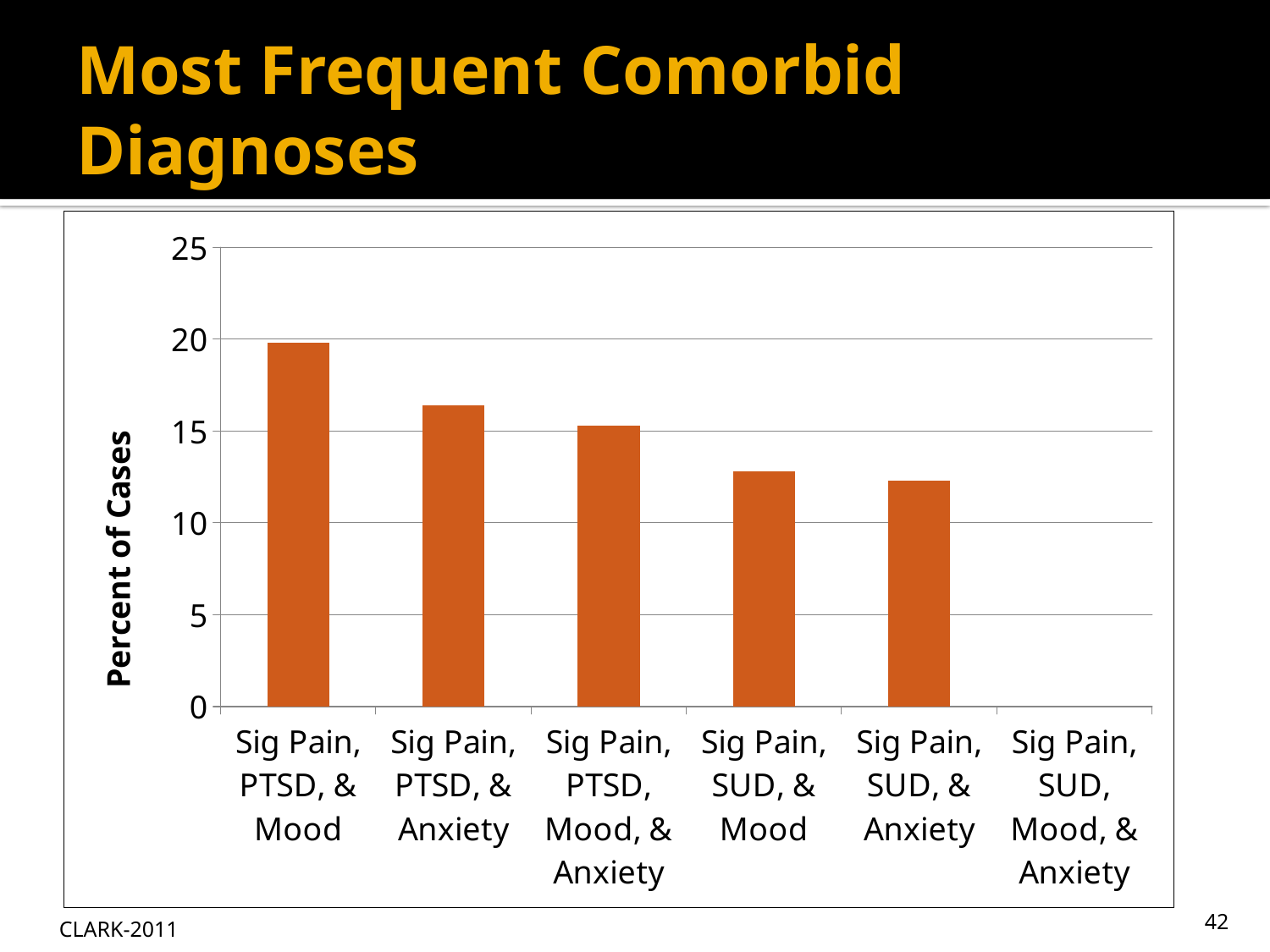
Which is larger, the value for Sig Pain, PTSD, & Anxiety or the value for Sig Pain, SUD, & Mood? Sig Pain, PTSD, & Anxiety What kind of chart is shown on the slide? Bar chart Which category has the highest percent of cases? Sig Pain, PTSD, & Mood Is the value for Sig Pain, SUD, & Anxiety greater or less than 10? greater How many categories are labelled on the x axis of the chart? 6 Is the value for Sig Pain, PTSD, & Mood greater or less than 15? greater Do the bar values rise or fall from left to right across the chart? Fall Is the value for Sig Pain, PTSD, Mood, & Anxiety greater or less than 20? less What colour are the bars in the chart? Orange What is the title of the y axis? Percent of Cases